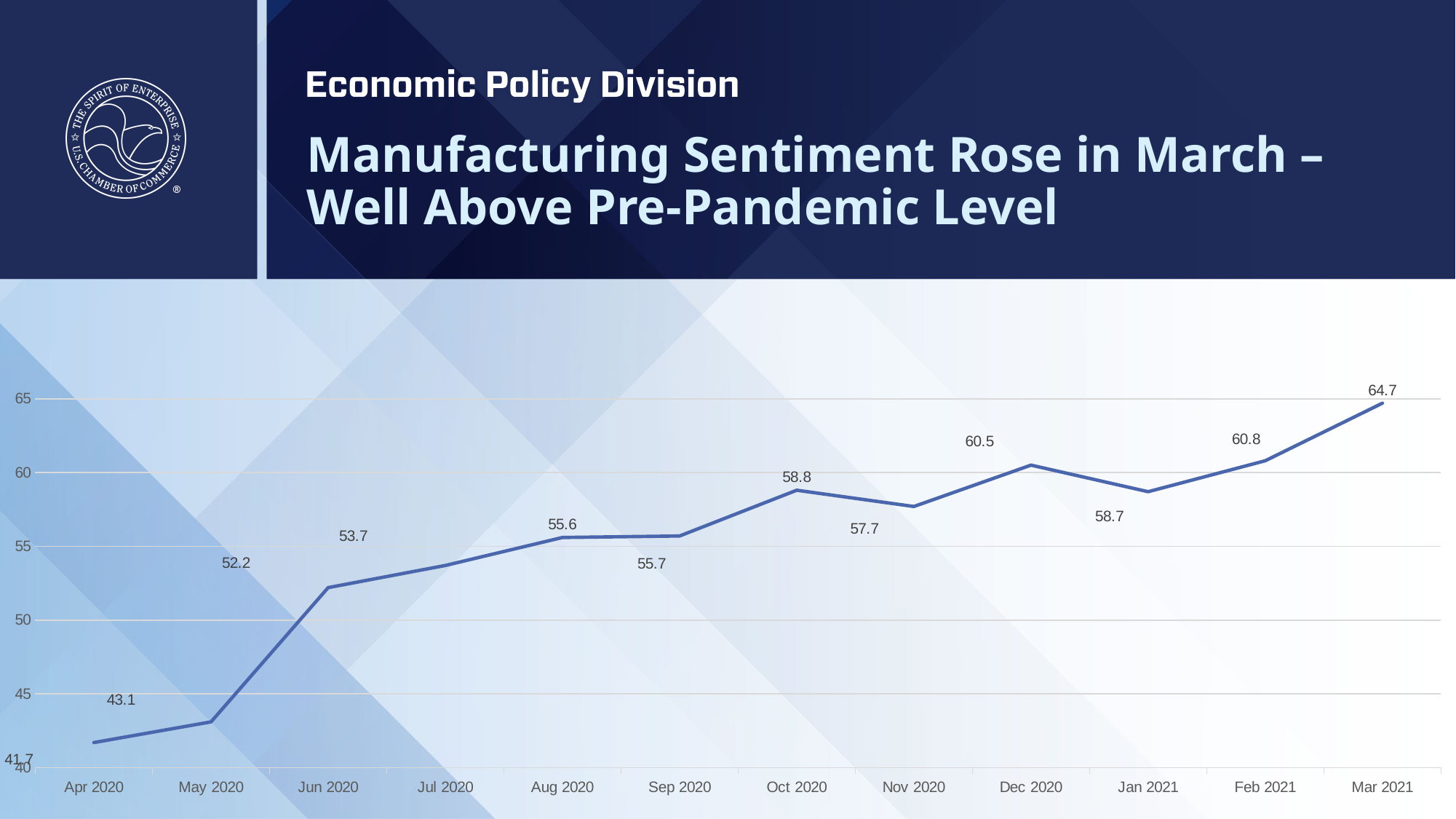
What is the value for Mar 2021? 64.7 How many months are plotted on the chart? 12 What is the difference between the values for Dec 2020 and Jan 2021? 1.8 Which month has the highest value? Mar 2021 What is the value for Jun 2020? 52.2 Is the value for May 2020 greater or less than 45? less Which month has the lowest value? Apr 2020 What kind of chart is shown on the slide? line chart What is the difference between the values for Mar 2021 and Apr 2020? 23.0 Do the values generally rise or fall from Apr 2020 to Mar 2021? rise What is the value for Nov 2020? 57.7 Which is larger, the value for Oct 2020 or the value for Nov 2020? Oct 2020